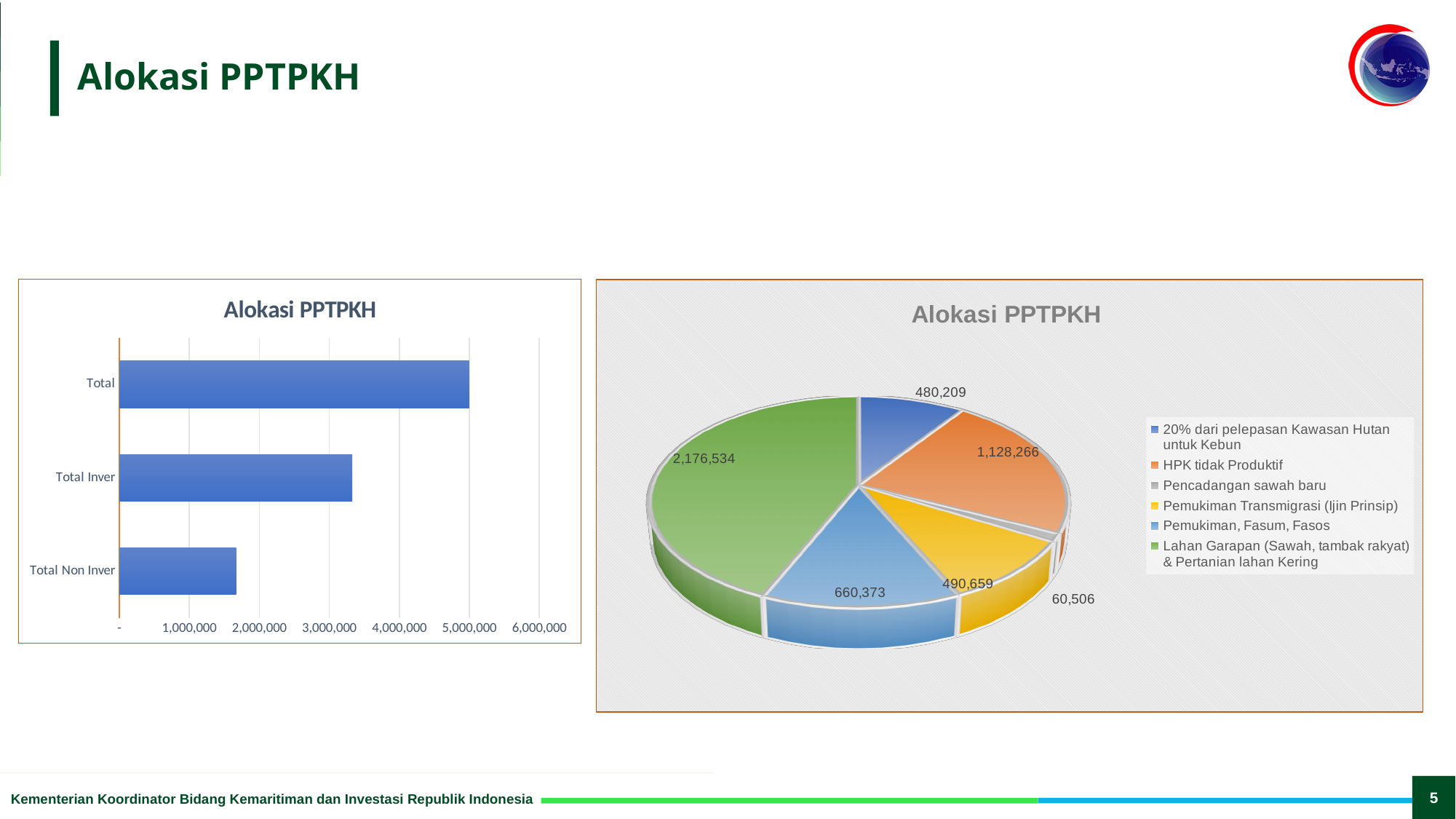
In the bar chart on the left, how many categories are shown? 3 In the bar chart on the left, which category has the highest value? Total How many entries does the legend of the pie chart on the right list? 6 In the pie chart on the right, what is the difference between the values for Pemukiman, Fasum, Fasos and Pemukiman Transmigrasi (Ijin Prinsip)? 169,714 In the pie chart on the right, what is the value for HPK tidak Produktif? 1,128,266 In the bar chart on the left, is the value for Total Non Inver greater or less than 2,000,000? less In the bar chart on the left, which category has the lowest value? Total Non Inver What type of chart is the chart on the left of the slide? bar chart In the pie chart on the right, what is the value for Lahan Garapan (Sawah, tambak rakyat) & Pertanian lahan Kering? 2,176,534 What type of chart is the chart on the right of the slide? pie chart In the pie chart on the right, which category has the smallest slice? Pencadangan sawah baru In the bar chart on the left, is the value for Total Inver greater or less than 3,000,000? greater